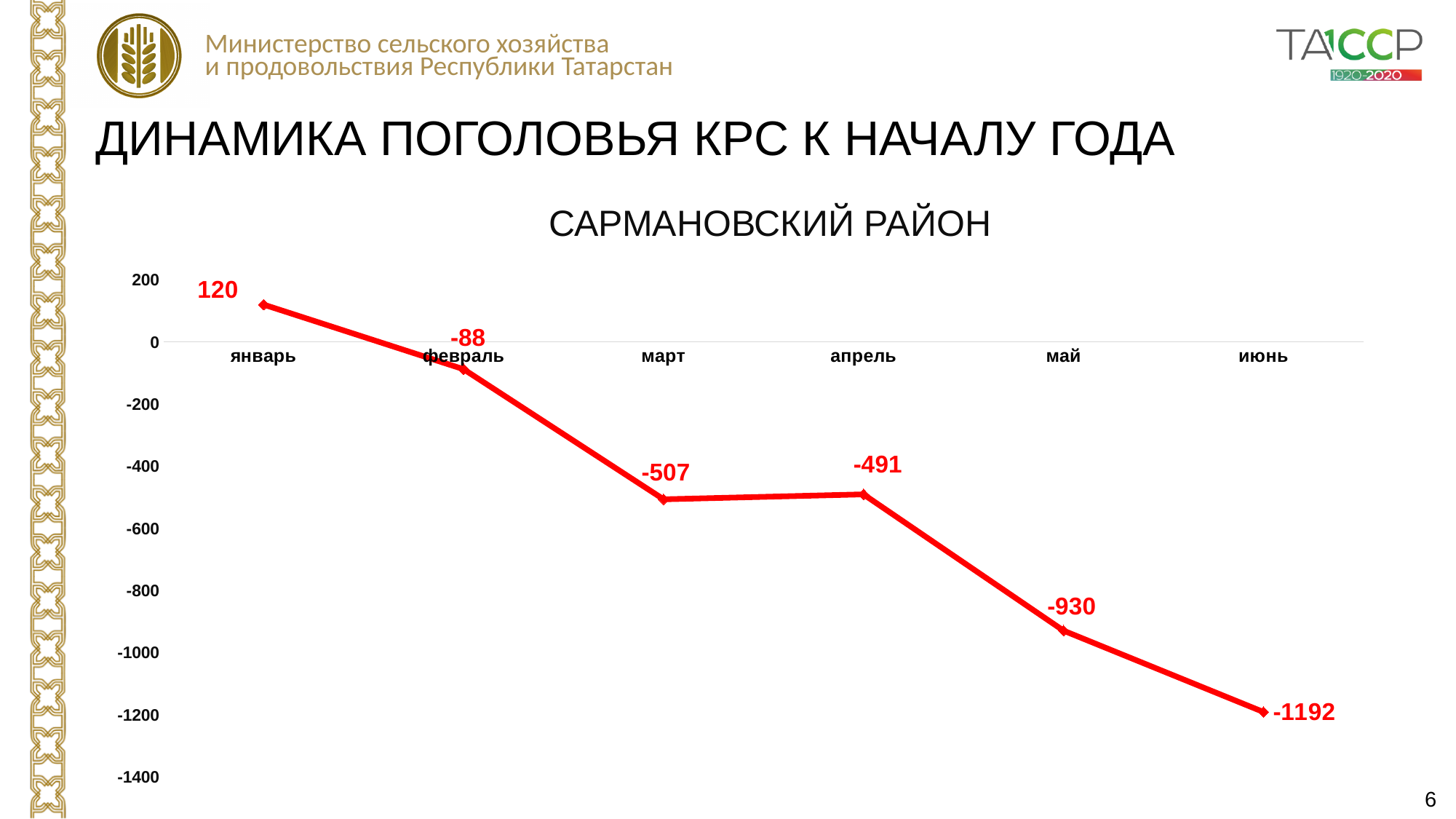
Which month has the lowest value? июнь What is the value for июнь? -1192 What is the title of the chart? САРМАНОВСКИЙ РАЙОН What is the value for март? -507 Which is larger, the value for февраль or the value for май? февраль Which month has the highest value? январь What is the value for январь? 120 How many months are plotted on the chart? 6 What kind of chart is shown on the slide? line chart Do the values generally rise or fall from январь to июнь? fall What is the difference between the values for апрель and март? 16 What is the value for май? -930